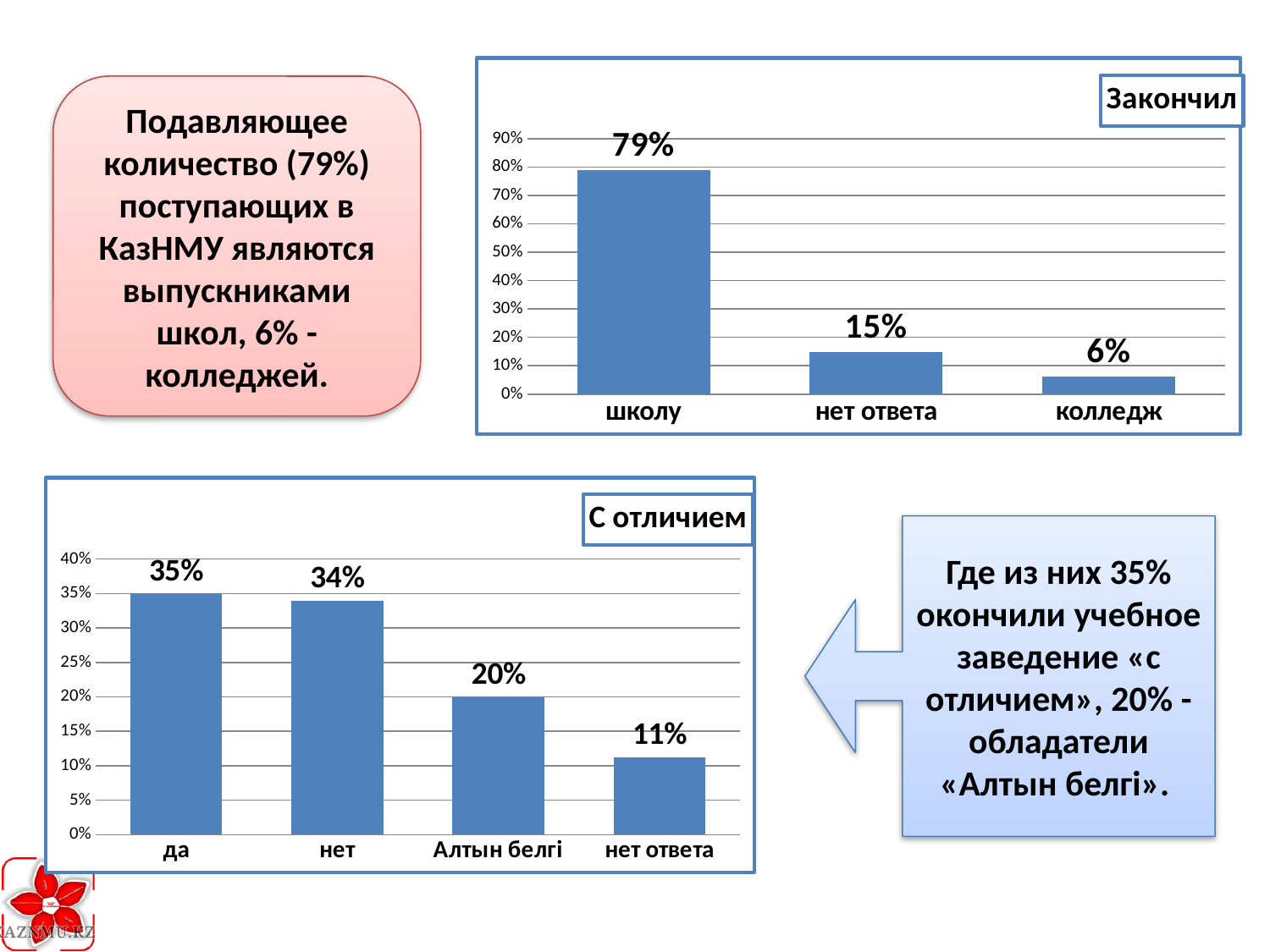
In the 'С отличием' chart, how many categories are shown? 4 What type of chart is the 'С отличием' chart? bar chart In the 'Закончил' chart, which category has the highest value? школу In the 'Закончил' chart, how many categories are shown? 3 In the 'Закончил' chart, what is the value for 'колледж'? 6% In the 'Закончил' chart, which category has the lowest value? колледж In the 'С отличием' chart, which category has the lowest value? нет ответа In the 'Закончил' chart, what is the value for 'школу'? 79% In the 'С отличием' chart, what is the value for 'Алтын белгі'? 20% In the 'С отличием' chart, what is the value for 'нет ответа'? 11% In the 'С отличием' chart, which is larger: 'да' or 'Алтын белгі'? да In the 'Закончил' chart, what is the difference between 'школу' and 'нет ответа'? 64%